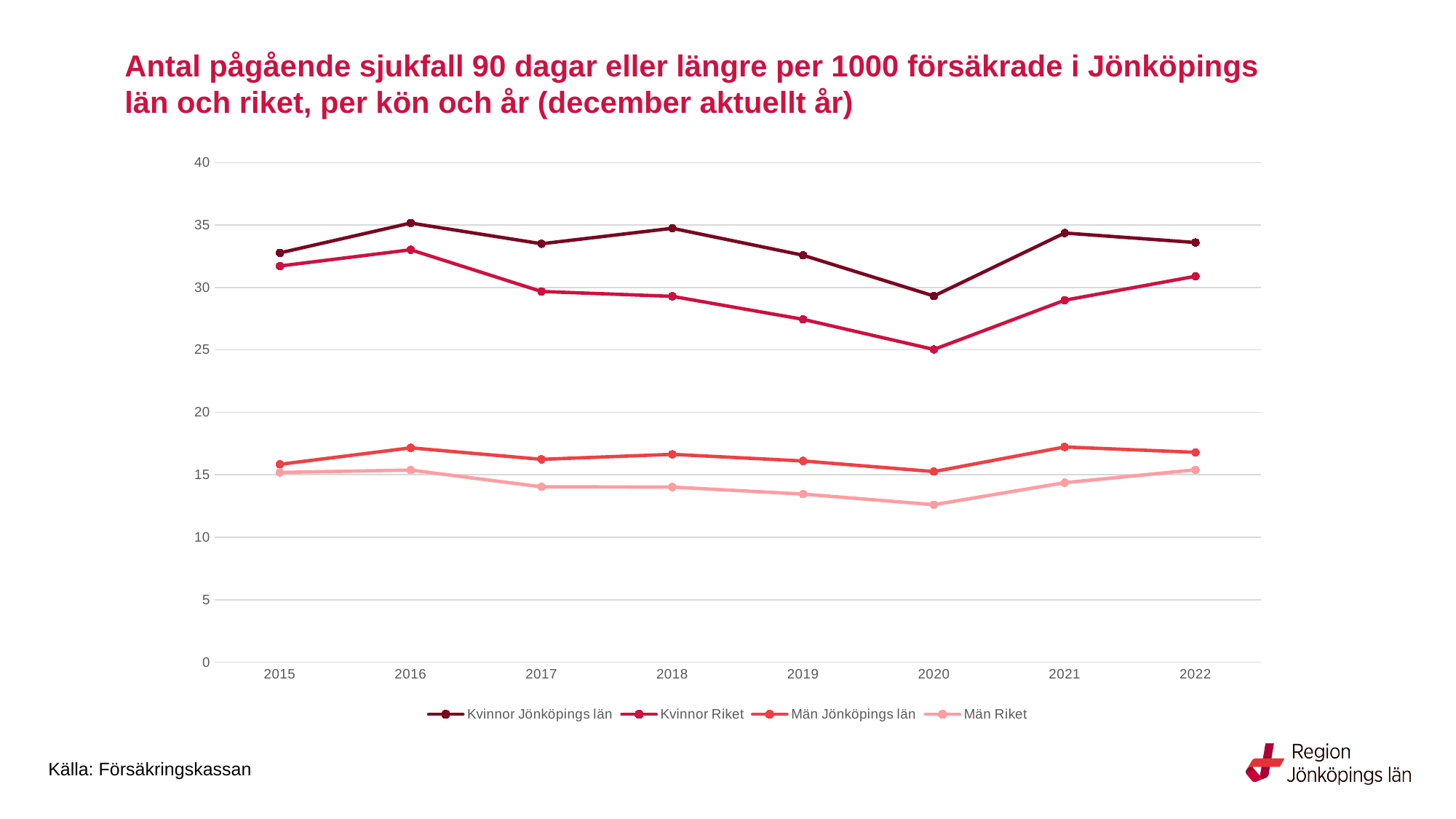
In 2018, which is larger: Kvinnor Jönköpings län or Kvinnor Riket? Kvinnor Jönköpings län In which year is the value for Kvinnor Riket lowest? 2020 How many years are shown on the x axis? 8 In which year is the value for Män Riket lowest? 2020 In which year is the value for Kvinnor Jönköpings län lowest? 2020 How many series does the legend list? 4 Is the value for Män Jönköpings län in 2021 greater or less than 15? greater Is the value for Män Riket in 2020 greater or less than 15? less Is the value for Kvinnor Riket in 2020 greater or less than 30? less Does the value for Kvinnor Riket rise or fall from 2016 to 2020? fall Which series is drawn in the lightest pink colour? Män Riket What kind of chart is shown on the slide? line chart